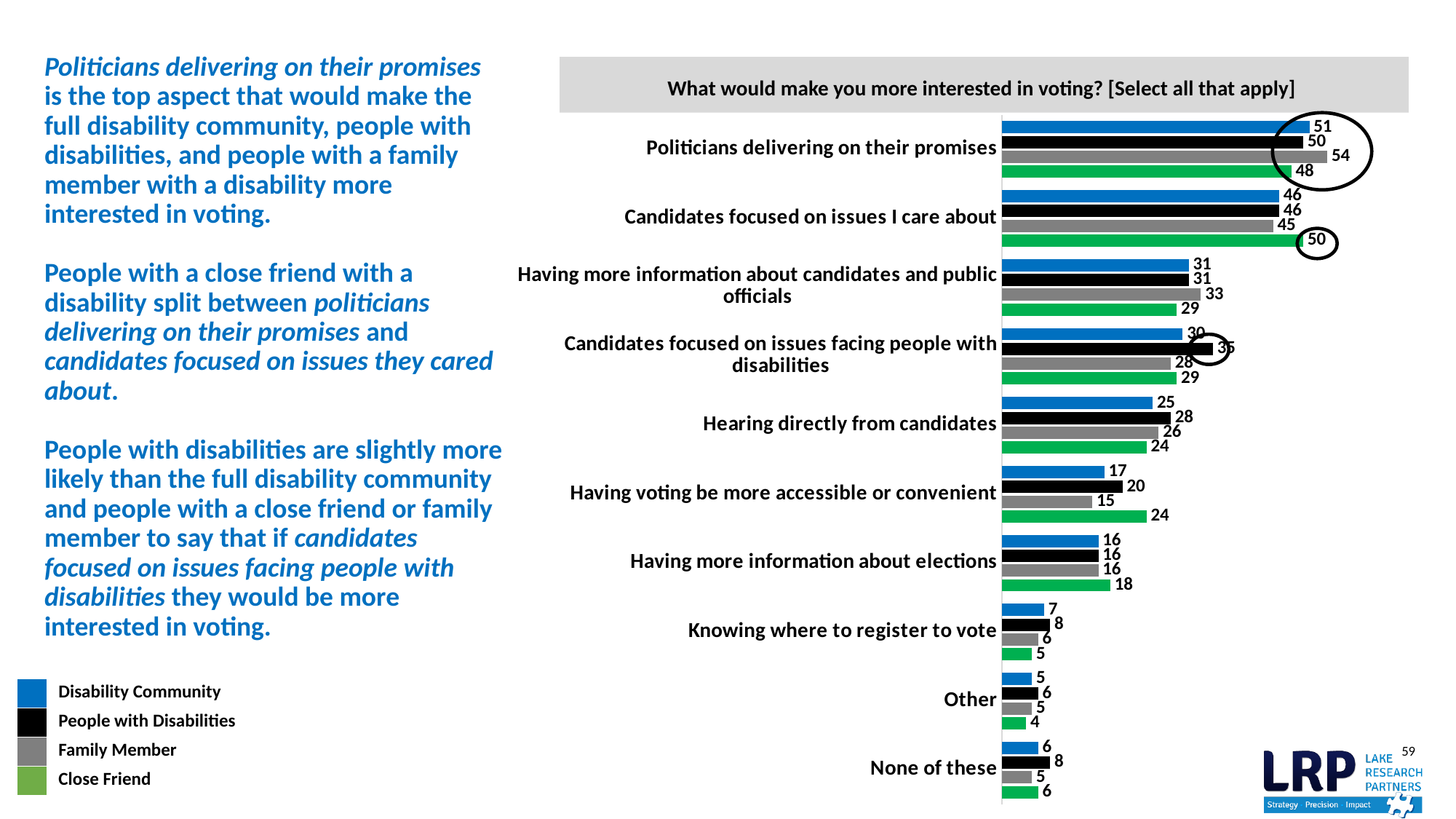
What kind of chart is shown on the slide? Bar chart Which category has the highest value for the Disability Community series? Politicians delivering on their promises Which category has the lowest value for the Close Friend series? Other What is the difference between the Family Member and Close Friend values for "Politicians delivering on their promises"? 6 How many categories are shown on the chart? 10 What is the value for Close Friend for "Having voting be more accessible or convenient"? 24 What is the value for People with Disabilities for "Candidates focused on issues facing people with disabilities"? 35 What is the value for Family Member for "Politicians delivering on their promises"? 54 How many series does the legend list? 4 What is the title of the chart? What would make you more interested in voting? [Select all that apply] For "Having voting be more accessible or convenient", which is larger: the People with Disabilities value or the Family Member value? People with Disabilities What is the value for Close Friend for "Candidates focused on issues I care about"? 50